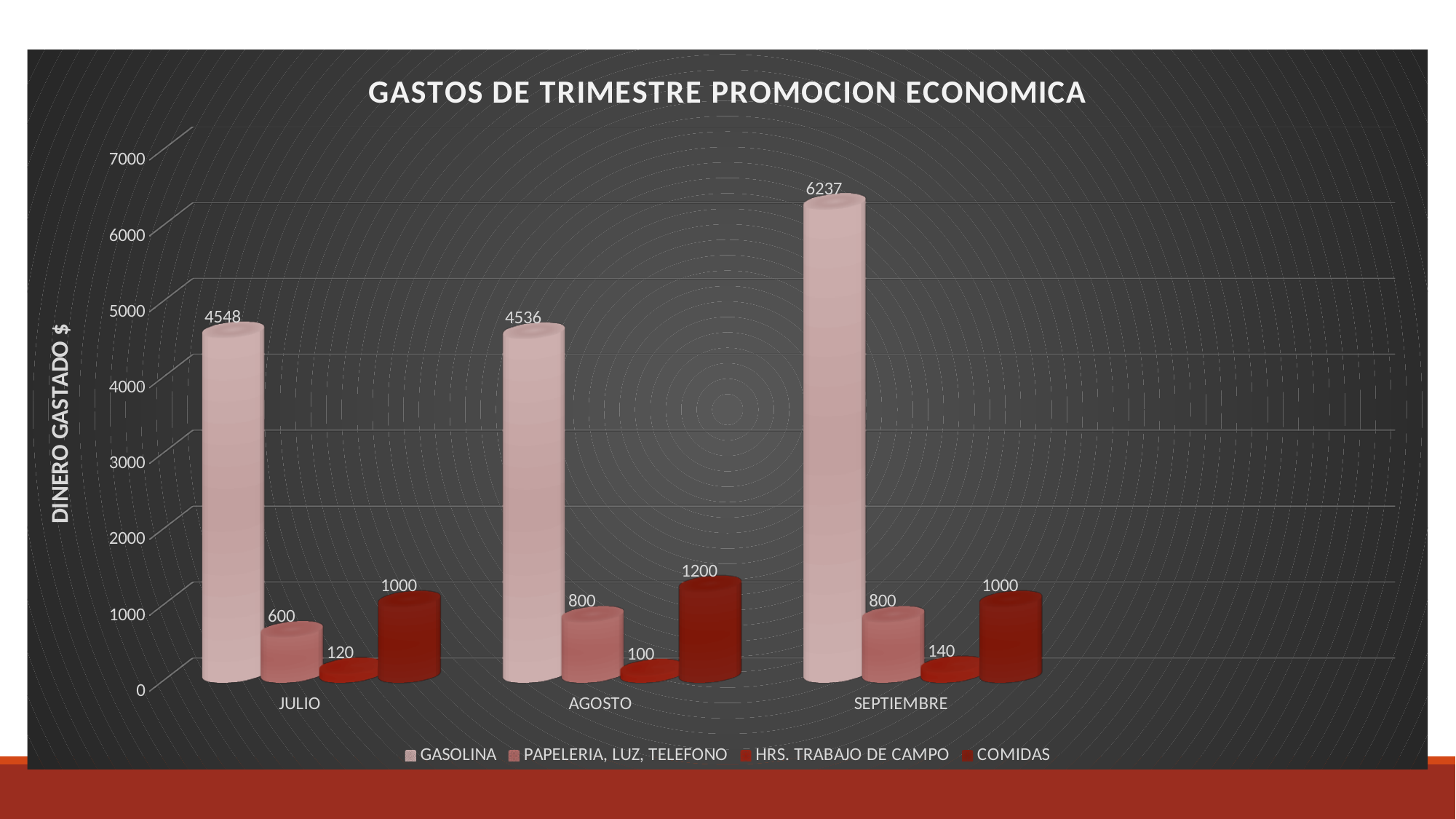
What kind of chart is shown? Bar chart How many months are shown on the x axis? 3 What is the GASOLINA value for SEPTIEMBRE? 6237 How many series does the legend list? 4 What is the COMIDAS value for AGOSTO? 1200 Which is larger, the COMIDAS value for AGOSTO or for SEPTIEMBRE? AGOSTO What is the HRS. TRABAJO DE CAMPO value for JULIO? 120 What is the title of the chart? GASTOS DE TRIMESTRE PROMOCION ECONOMICA What is the PAPELERIA, LUZ, TELEFONO value for AGOSTO? 800 Which month has the lowest HRS. TRABAJO DE CAMPO value? AGOSTO Which month has the highest GASOLINA value? SEPTIEMBRE What is the difference between the GASOLINA values for SEPTIEMBRE and JULIO? 1689